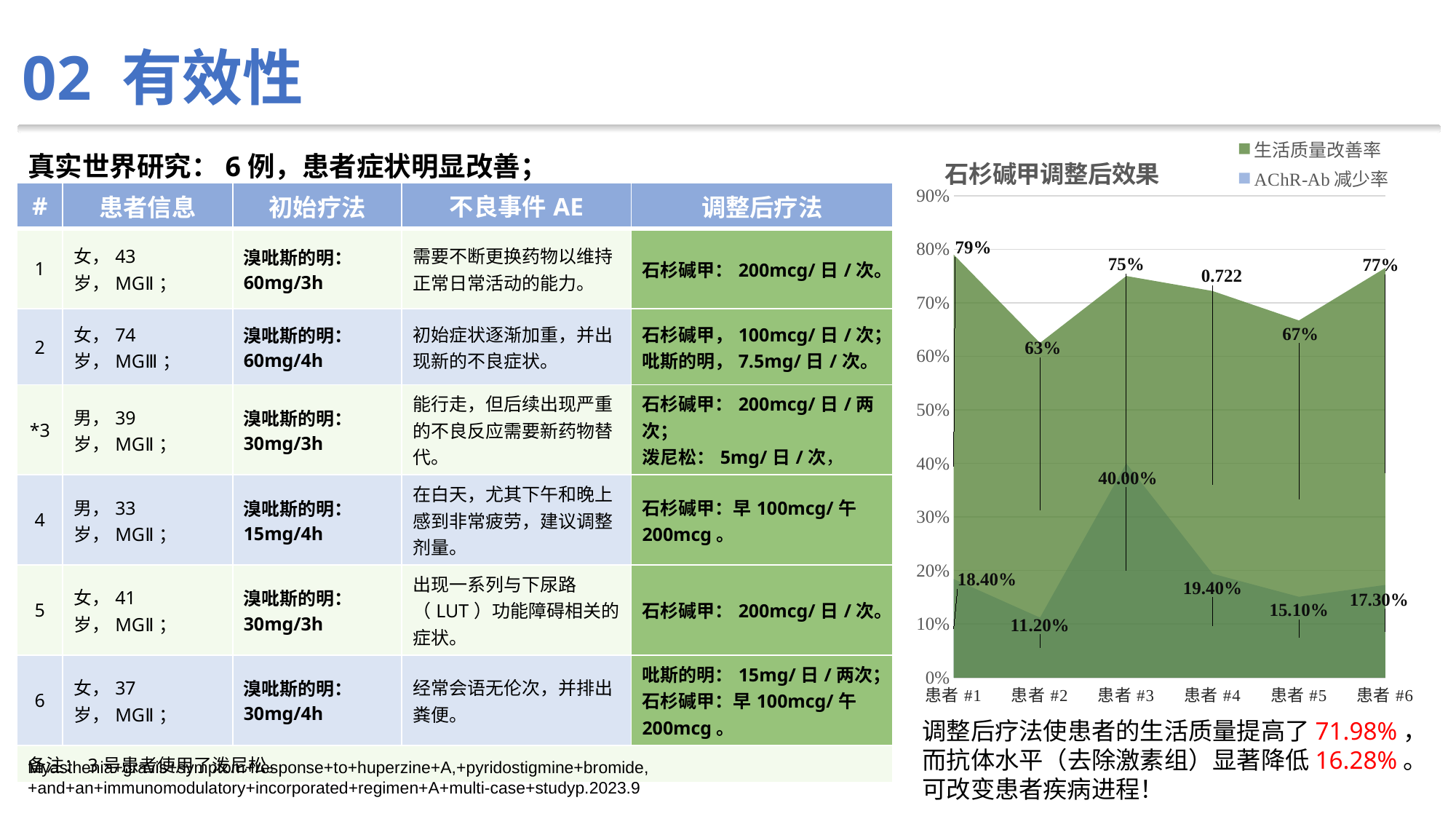
Which is larger, the 生活质量改善率 of 患者 #3 or of 患者 #5? 患者 #3 Is the AChR-Ab 减少率 for 患者 #1 greater or less than 20%? less How many patients are shown on the x axis of the chart? 6 What is the 生活质量改善率 value for 患者 #4 as printed on the chart? 0.722 How many series does the chart legend list? 2 Which patient has the highest 生活质量改善率? 患者 #1 What is the AChR-Ab 减少率 value for 患者 #3? 40.00% What is the difference between the AChR-Ab 减少率 of 患者 #3 and 患者 #2? 28.80% Which patient has the lowest AChR-Ab 减少率? 患者 #2 What is the title of the chart? 石杉碱甲调整后效果 What is the AChR-Ab 减少率 value for 患者 #5? 15.10% What is the 生活质量改善率 value for 患者 #1? 79%